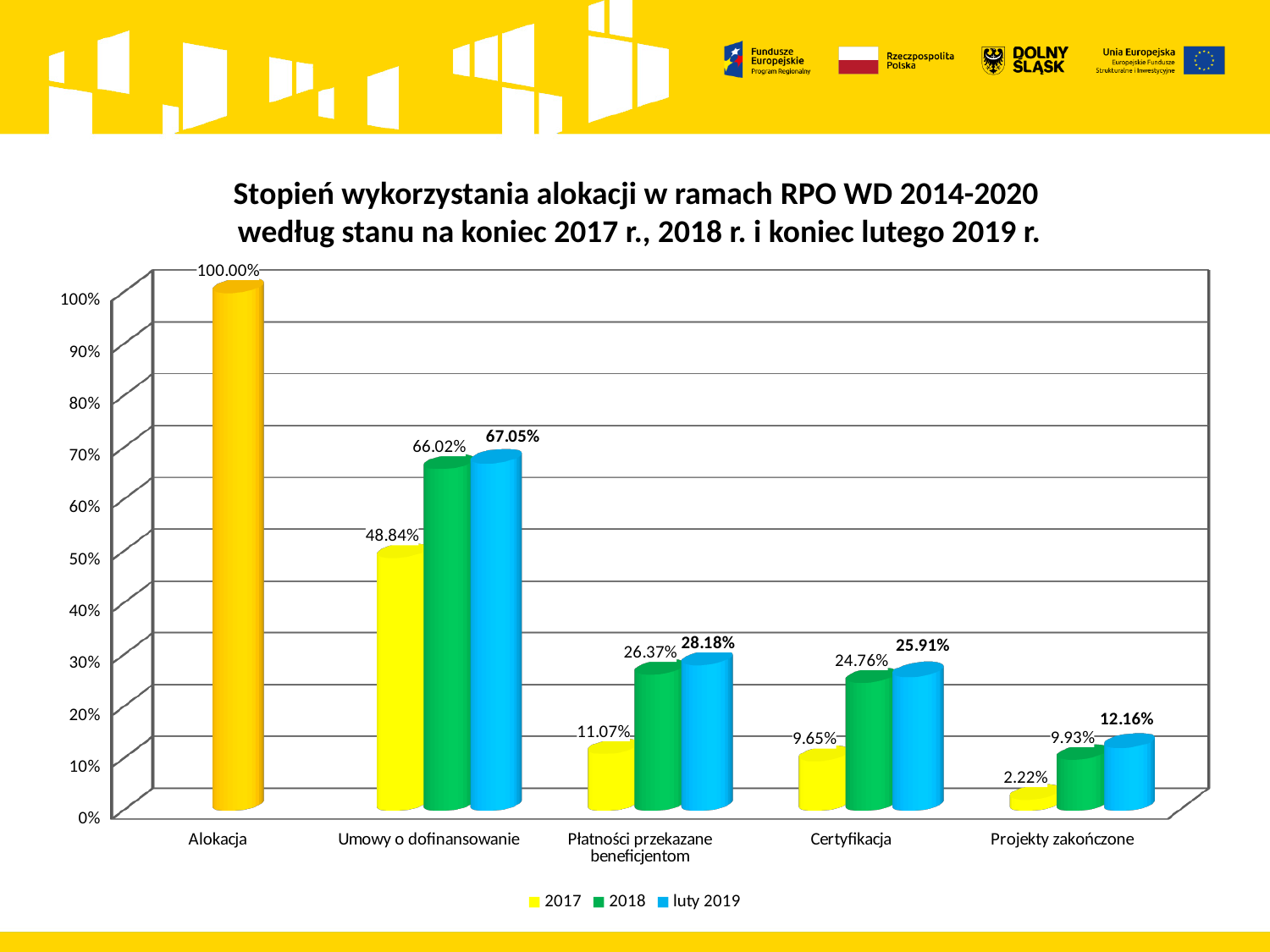
What is the value for 'Projekty zakończone' in the '2018' series? 9.93% What is the difference between the 'luty 2019' and '2017' values for 'Umowy o dofinansowanie'? 18.21% What kind of chart is shown on the slide? Bar chart How many categories are shown on the x axis? 5 What is the value for 'Umowy o dofinansowanie' in the 'luty 2019' series? 67.05% What is the value for 'Certyfikacja' in the '2017' series? 9.65% Which category has the lowest value in the '2017' series? Projekty zakończone Which is larger: the 'luty 2019' value for 'Certyfikacja' or the 'luty 2019' value for 'Płatności przekazane beneficjentom'? Płatności przekazane beneficjentom Which category has the highest value in the 'luty 2019' series? Umowy o dofinansowanie What is the value for 'Płatności przekazane beneficjentom' in the '2018' series? 26.37% What is the value shown for 'Alokacja'? 100.00% How many series does the legend list? 3